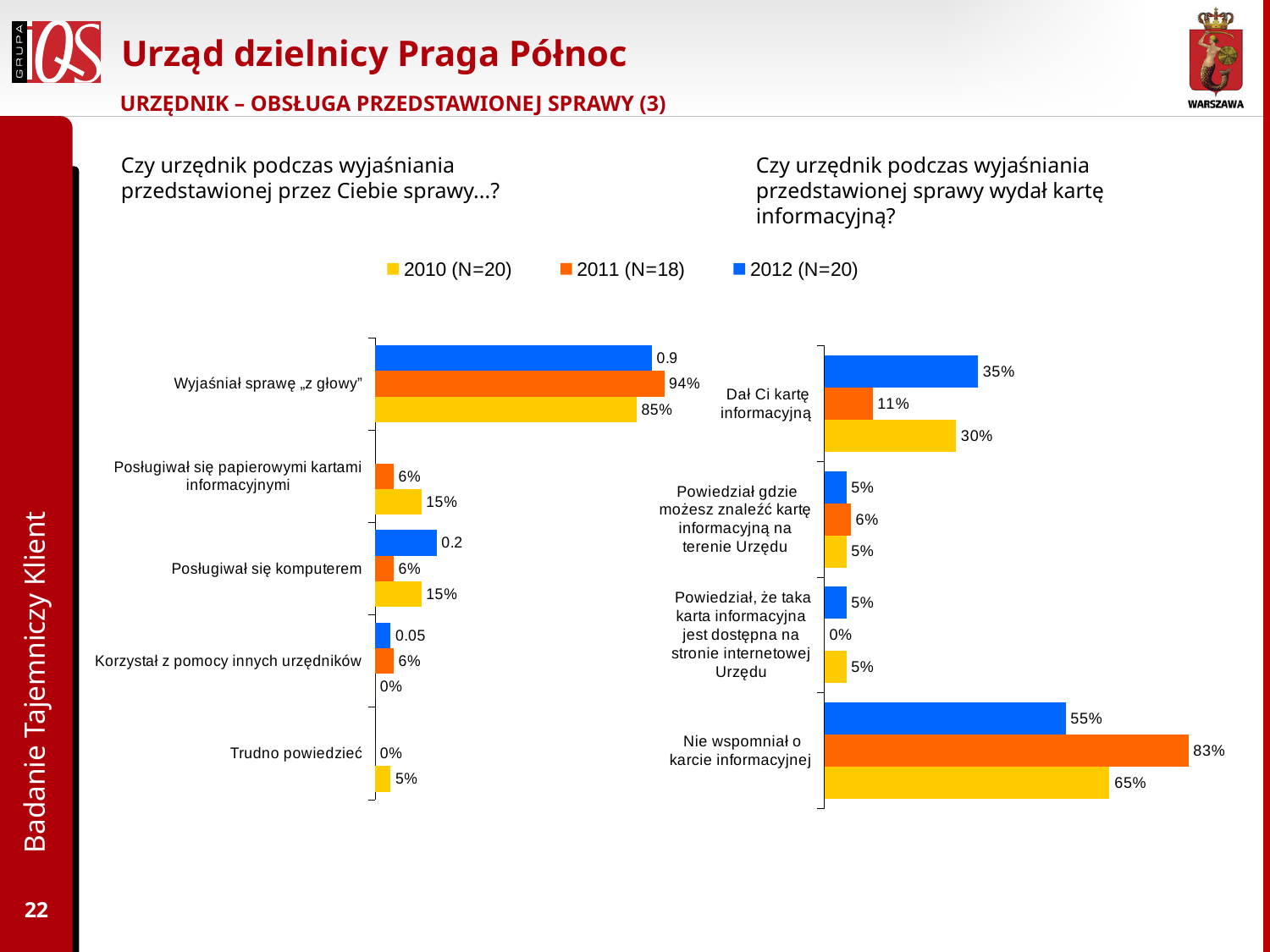
Which colour represents the 2011 (N=18) series in the legend? Orange In the left chart, what value is labelled for 2012 (N=20) on "Wyjaśniał sprawę „z głowy""? 0.9 In the right chart, which category has the highest 2012 (N=20) value? Nie wspomniał o karcie informacyjnej In the right chart, what is the 2011 (N=18) value for "Nie wspomniał o karcie informacyjnej"? 83% How many series does the legend list? 3 In the right chart, which is larger for "Dał Ci kartę informacyjną": the 2010 (N=20) value or the 2011 (N=18) value? 2010 (N=20) In the right chart, what is the 2012 (N=20) value for "Dał Ci kartę informacyjną"? 35% What type of chart is the right chart? Bar chart In the left chart, what is the 2011 (N=18) value for "Wyjaśniał sprawę „z głowy""? 94% In the left chart, what is the 2010 (N=20) value for "Posługiwał się komputerem"? 15% How many categories does the left chart show? 5 In the right chart, what is the difference between the 2010 (N=20) and 2011 (N=18) values for "Nie wspomniał o karcie informacyjnej"? 18%